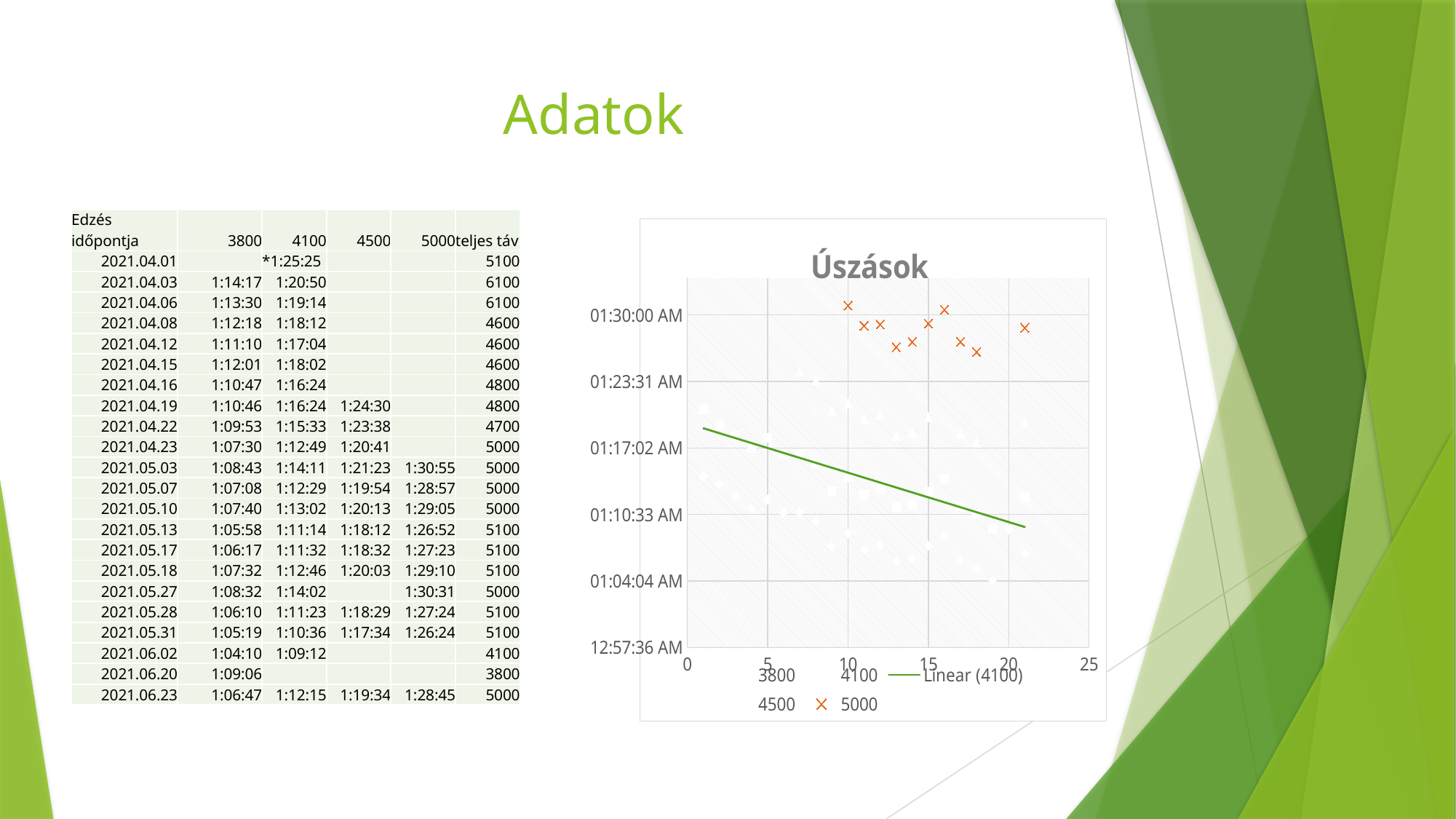
What kind of chart is shown on the slide? scatter chart What is the highest value shown on the x axis? 25 Is the left end of the green 'Linear (4100)' line above or below the 01:17:02 AM gridline? above Is the right end of the green 'Linear (4100)' line above or below the 01:17:02 AM gridline? below Does the green 'Linear (4100)' trend line rise or fall as x increases? fall How many orange X markers for the 5000 series are plotted on the chart? 10 Which legend entry is drawn with orange X markers? 5000 Are the orange 5000 series points plotted above or below the 01:23:31 AM gridline? above What is the title of the chart? Úszások How many entries does the chart's legend list? 5